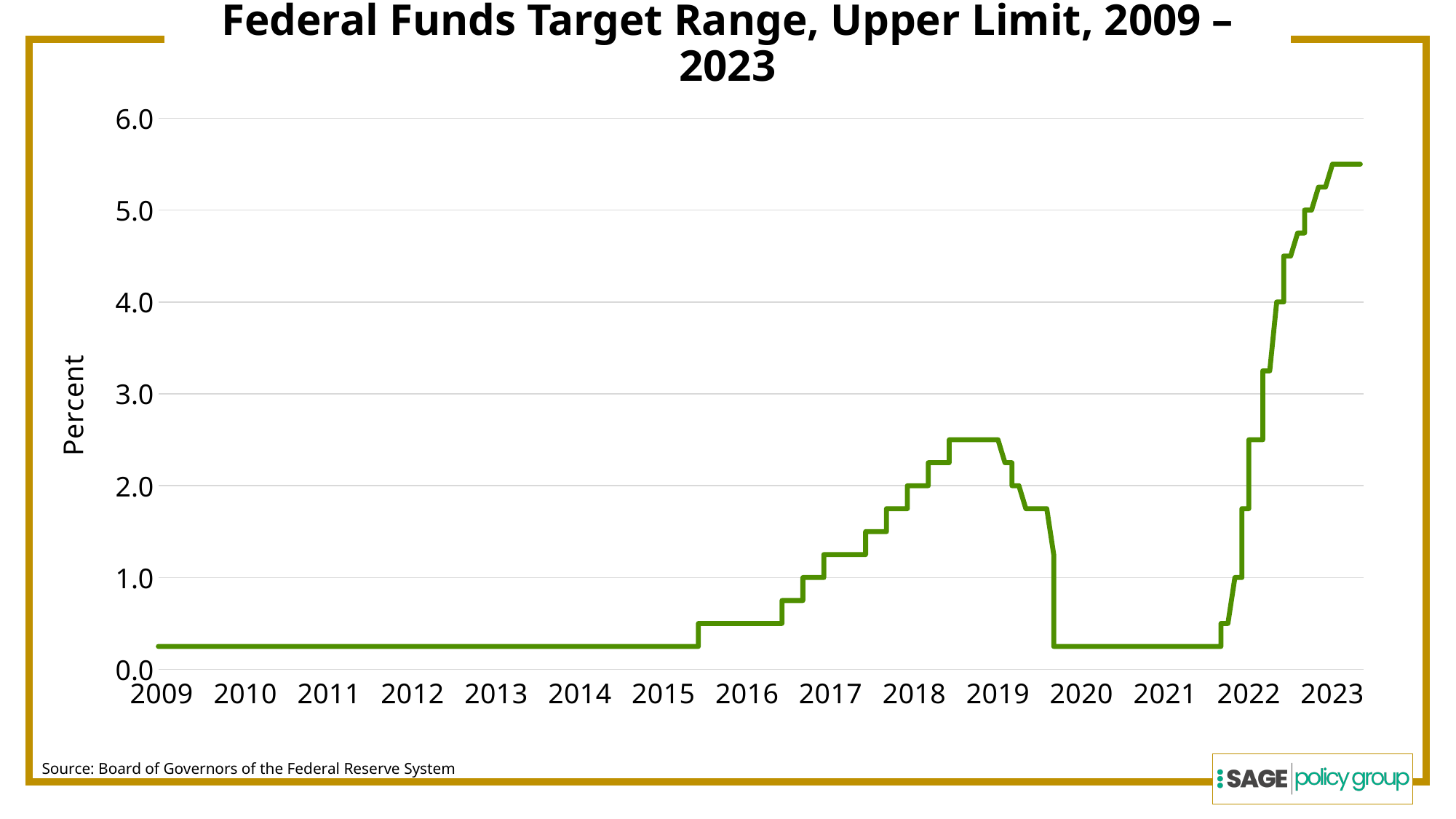
Is the value for 2013 greater or less than 1.0? less Which is larger, the value in 2023 or the value in 2019? 2023 Is the value for 2021 greater or less than 1.0? less Which is larger, the value in 2018 or the value in 2021? 2018 What is the label on the vertical axis of the chart? Percent What kind of chart is shown on the slide? line chart What is the title of the chart? Federal Funds Target Range, Upper Limit, 2009 – 2023 Does the line rise or fall between 2022 and 2023? rise How many year labels are shown on the x axis? 15 Which year shows the highest value on the chart? 2023 Is the value at the end of 2018 greater or less than 2.0? greater